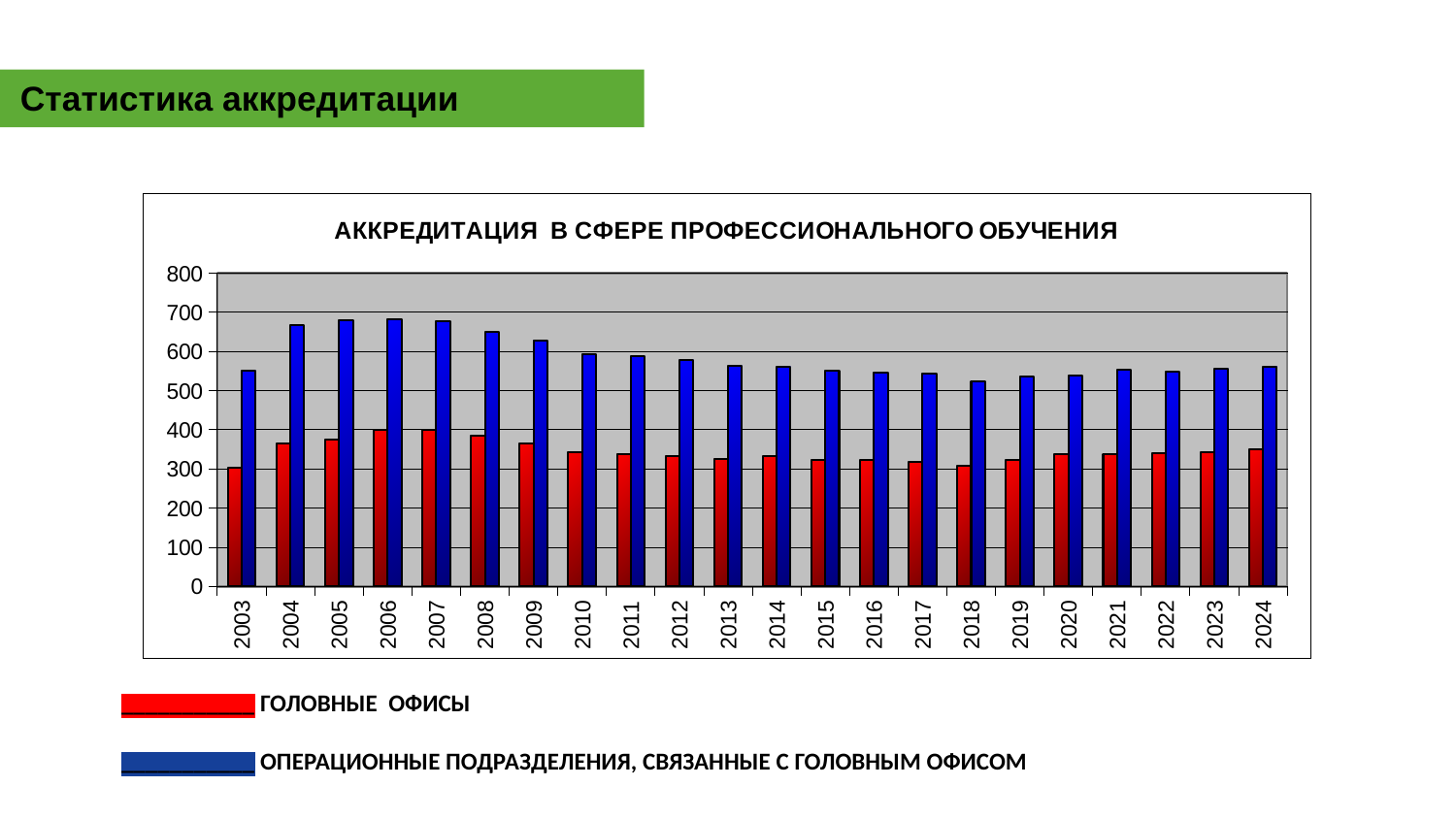
Which is larger in 2010: ГОЛОВНЫЕ ОФИСЫ or ОПЕРАЦИОННЫЕ ПОДРАЗДЕЛЕНИЯ? ОПЕРАЦИОННЫЕ ПОДРАЗДЕЛЕНИЯ For ОПЕРАЦИОННЫЕ ПОДРАЗДЕЛЕНИЯ, which year has the larger value: 2006 or 2018? 2006 Which colour represents ГОЛОВНЫЕ ОФИСЫ in the legend? Red How many series does the legend list? 2 Is the value for ГОЛОВНЫЕ ОФИСЫ in 2024 greater or less than 400? less Is the value for ОПЕРАЦИОННЫЕ ПОДРАЗДЕЛЕНИЯ in 2018 greater or less than 600? less Do the values for ОПЕРАЦИОННЫЕ ПОДРАЗДЕЛЕНИЯ rise or fall from 2007 to 2018? Fall Is the value for ОПЕРАЦИОННЫЕ ПОДРАЗДЕЛЕНИЯ in 2006 greater or less than 600? greater What is the title of the chart? АККРЕДИТАЦИЯ В СФЕРЕ ПРОФЕССИОНАЛЬНОГО ОБУЧЕНИЯ How many years are shown on the x axis of the chart? 22 What kind of chart is shown on the slide? Bar chart